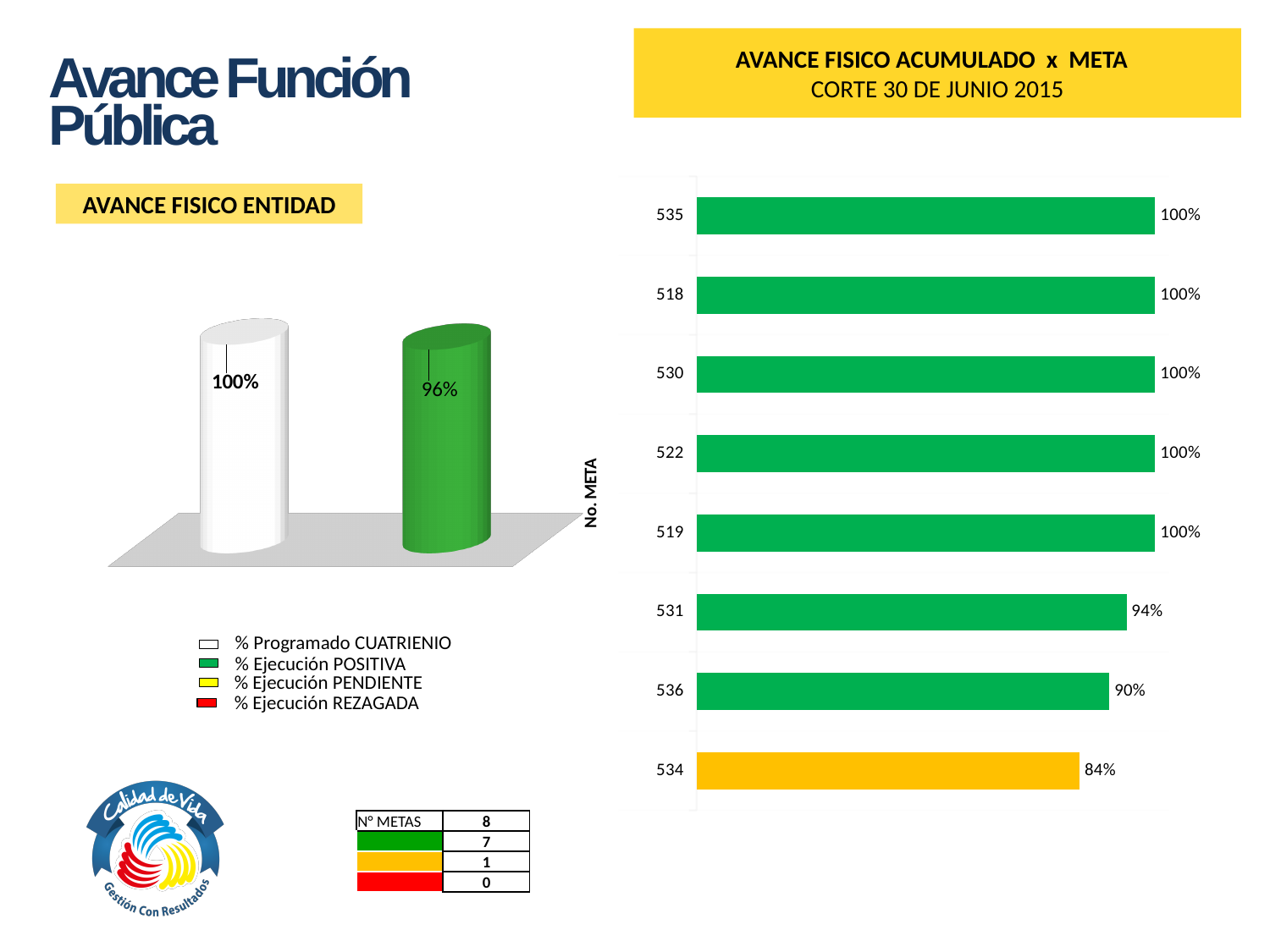
In the AVANCE FISICO ACUMULADO x META chart, what is the difference between the values for meta 531 and meta 534? 10% In the AVANCE FISICO ACUMULADO x META chart, how many metas have a value of 100%? 5 How many entries does the legend of the AVANCE FISICO ENTIDAD chart list? 4 How many metas are shown in the AVANCE FISICO ACUMULADO x META chart? 8 In the AVANCE FISICO ENTIDAD chart, what is the difference between % Programado CUATRIENIO and % Ejecución POSITIVA? 4% In the AVANCE FISICO ACUMULADO x META chart, what is the value for meta 531? 94% In the AVANCE FISICO ENTIDAD chart, what is the value for % Ejecución POSITIVA? 96% In the AVANCE FISICO ACUMULADO x META chart, what is the value for meta 534? 84% In the AVANCE FISICO ACUMULADO x META chart, which meta has the lowest value? 534 What kind of chart is the AVANCE FISICO ACUMULADO x META chart? bar chart In the AVANCE FISICO ACUMULADO x META chart, what is the value for meta 536? 90% In the AVANCE FISICO ACUMULADO x META chart, which is larger, the value for meta 536 or meta 531? 531